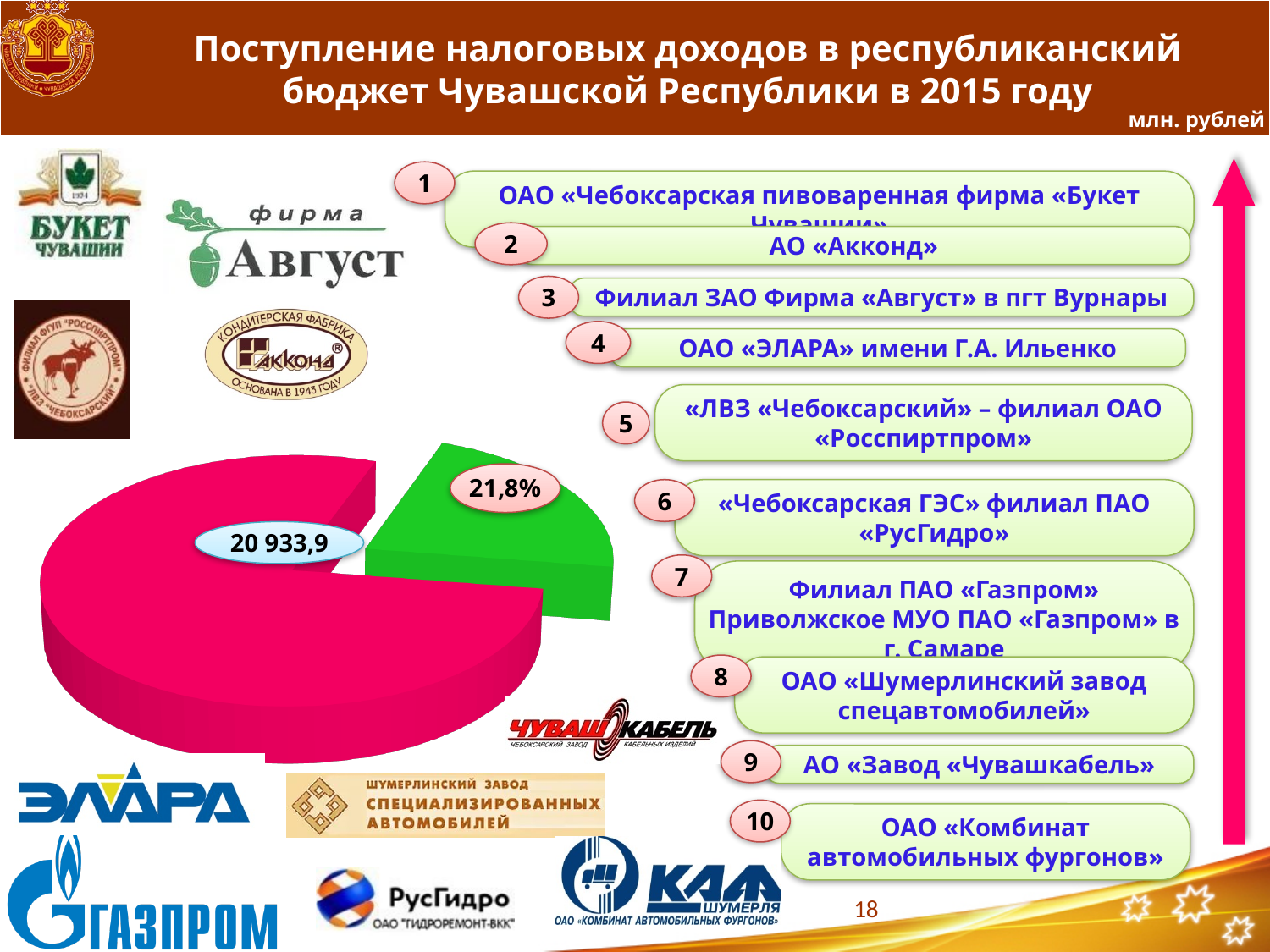
Which slice of the pie chart is larger, the pink one or the green one? the pink one What percentage is printed on the green slice of the pie chart? 21,8% What is the title of the slide containing the pie chart? Поступление налоговых доходов в республиканский бюджет Чувашской Республики в 2015 году What value is printed on the large pink slice of the pie chart? 20 933,9 Is the share of the green slice greater or less than 50%? less What unit of measurement is stated for the chart on the slide? млн. рублей What kind of chart is shown on the slide? pie chart How many slices does the pie chart have? 2